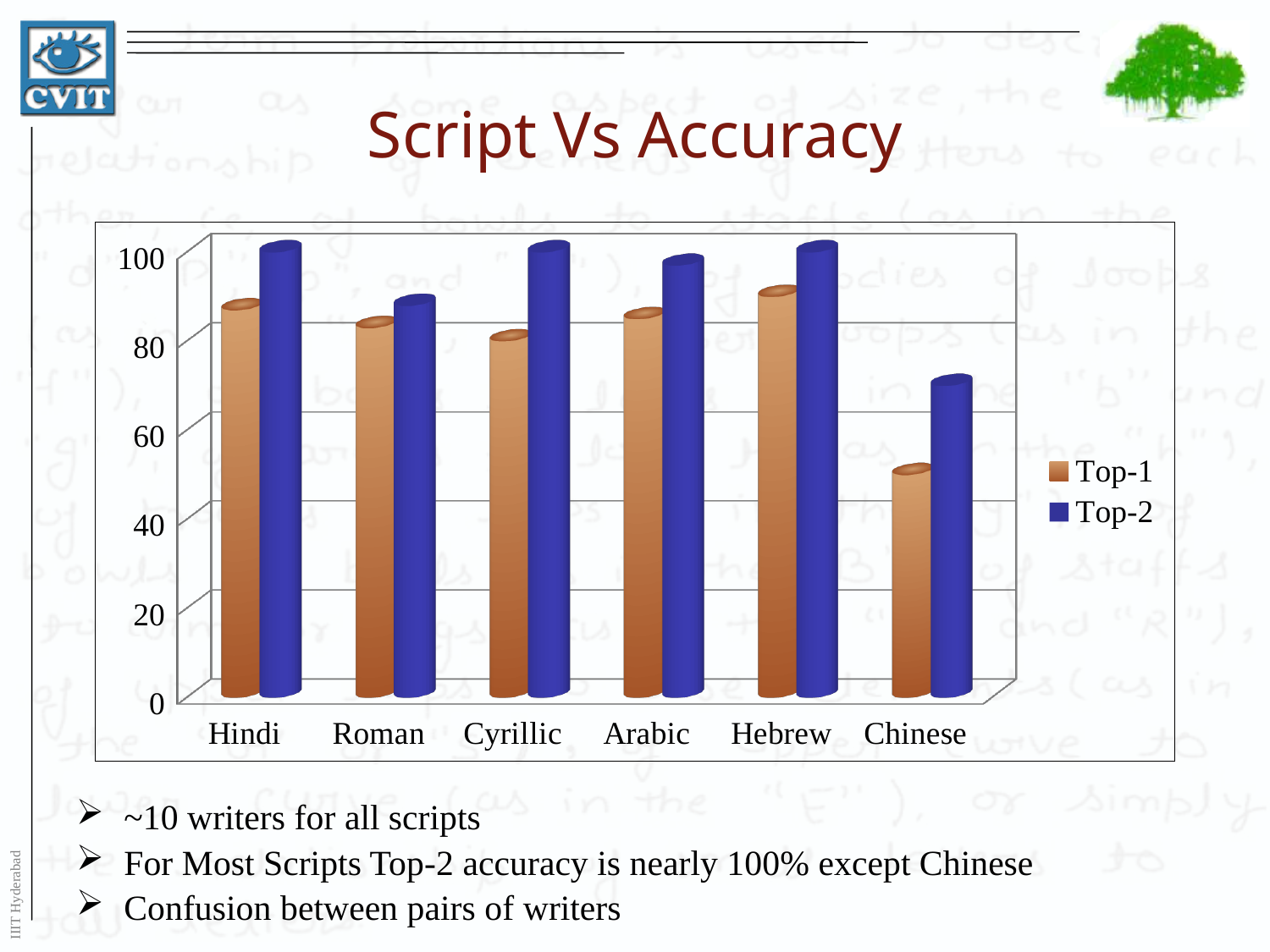
What are the two series named in the legend? Top-1 and Top-2 What kind of chart is shown on the slide? bar chart Which script has the lowest Top-1 accuracy? Chinese Which is larger, the Top-2 value for Roman or the Top-2 value for Cyrillic? Cyrillic How many scripts are shown on the x axis of the chart? 6 Is the Top-2 value for Chinese greater or less than 80? less Is the Top-1 value for Hebrew greater or less than 80? greater Is the Top-1 value for Chinese greater or less than 60? less What is the title of the chart? Script Vs Accuracy Which script has the lowest Top-2 accuracy? Chinese How many series does the chart legend list? 2 Which is larger, the Top-1 value for Hebrew or the Top-1 value for Chinese? Hebrew